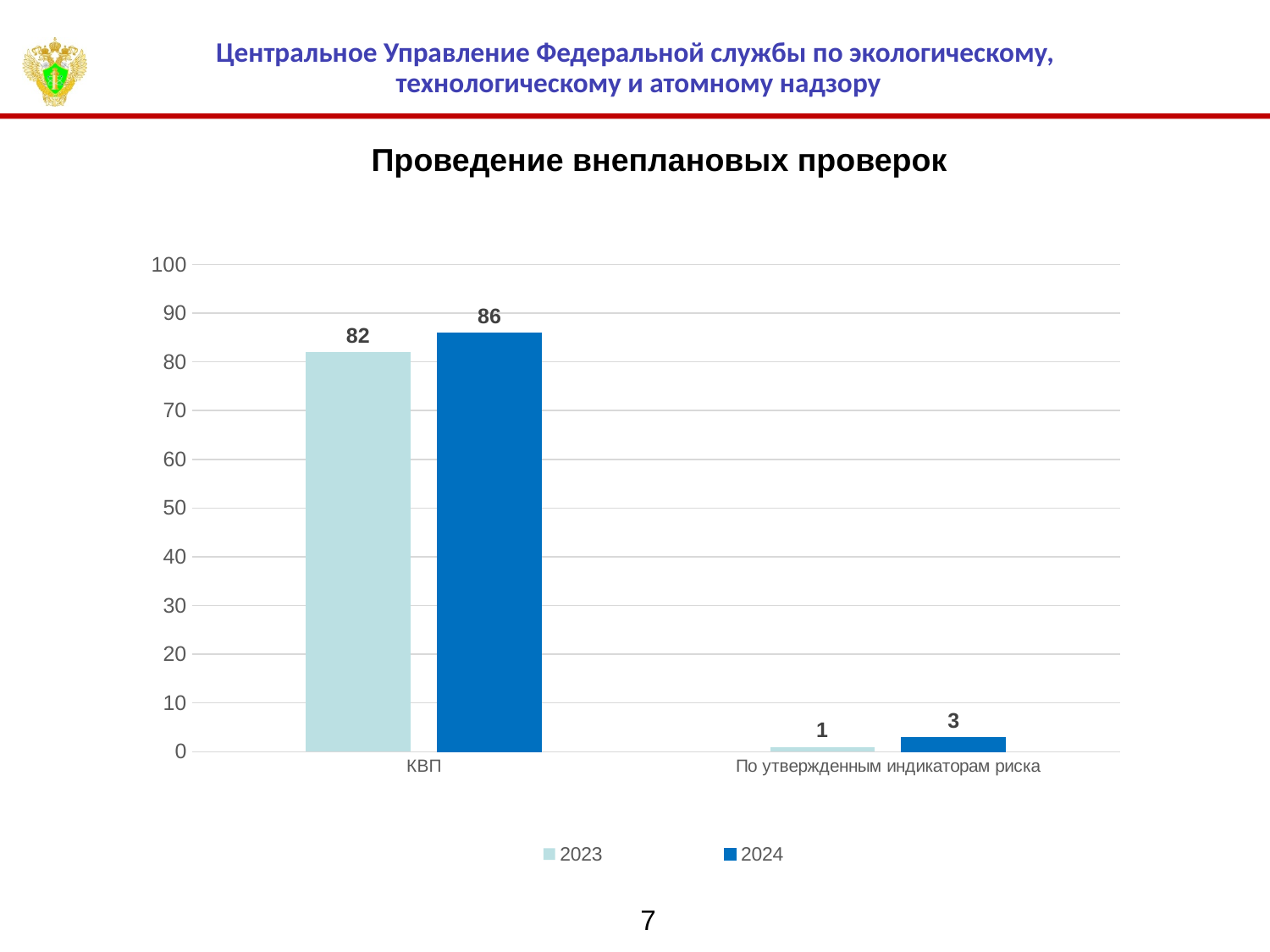
Is the value for КВП in 2024 greater or less than 80? greater Which is larger for По утвержденным индикаторам риска: the 2023 value or the 2024 value? 2024 What kind of chart is shown on the slide? bar chart What is the value for По утвержденным индикаторам риска in 2023? 1 What is the value for КВП in 2024? 86 How many categories are shown on the x axis? 2 Which category has the highest value in 2024? КВП What is the value for По утвержденным индикаторам риска in 2024? 3 What is the value for КВП in 2023? 82 What is the difference between the 2024 and 2023 values for КВП? 4 How many series does the legend list? 2 Which category has the lowest value in 2023? По утвержденным индикаторам риска